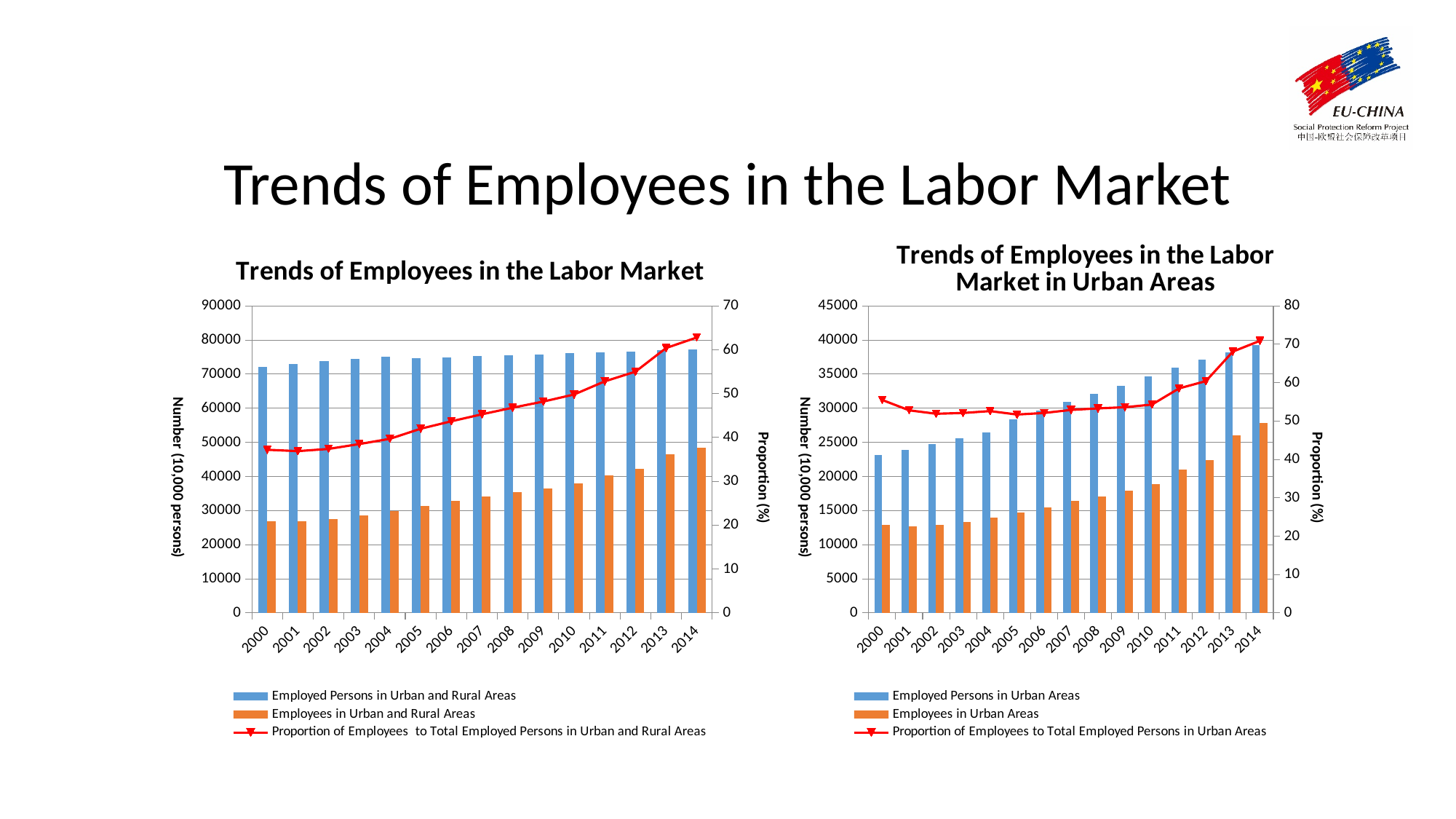
On the left chart titled 'Trends of Employees in the Labor Market', how many series does the legend list? 3 On the right chart titled 'Trends of Employees in the Labor Market in Urban Areas', what is the label of the right-hand vertical axis? Proportion (%) On the right chart titled 'Trends of Employees in the Labor Market in Urban Areas', which is larger: Employed Persons in Urban Areas in 2000 or in 2014? 2014 On the right chart titled 'Trends of Employees in the Labor Market in Urban Areas', is the value for Employed Persons in Urban Areas in 2014 greater or less than 35000? greater What kind of chart is the left chart titled 'Trends of Employees in the Labor Market'? Bar chart with a line series On the right chart titled 'Trends of Employees in the Labor Market in Urban Areas', is the value for Employees in Urban Areas in 2000 greater or less than 15000? less On the left chart titled 'Trends of Employees in the Labor Market', how many years are shown on the x axis? 15 On the left chart titled 'Trends of Employees in the Labor Market', is the value for Employed Persons in Urban and Rural Areas in 2000 greater or less than 80000? less On the left chart titled 'Trends of Employees in the Labor Market', do the values for Employees in Urban and Rural Areas rise or fall from 2000 to 2014? Rise On the left chart titled 'Trends of Employees in the Labor Market', which year has the highest value for Employees in Urban and Rural Areas? 2014 On the right chart titled 'Trends of Employees in the Labor Market in Urban Areas', which year has the highest value for Employees in Urban Areas? 2014